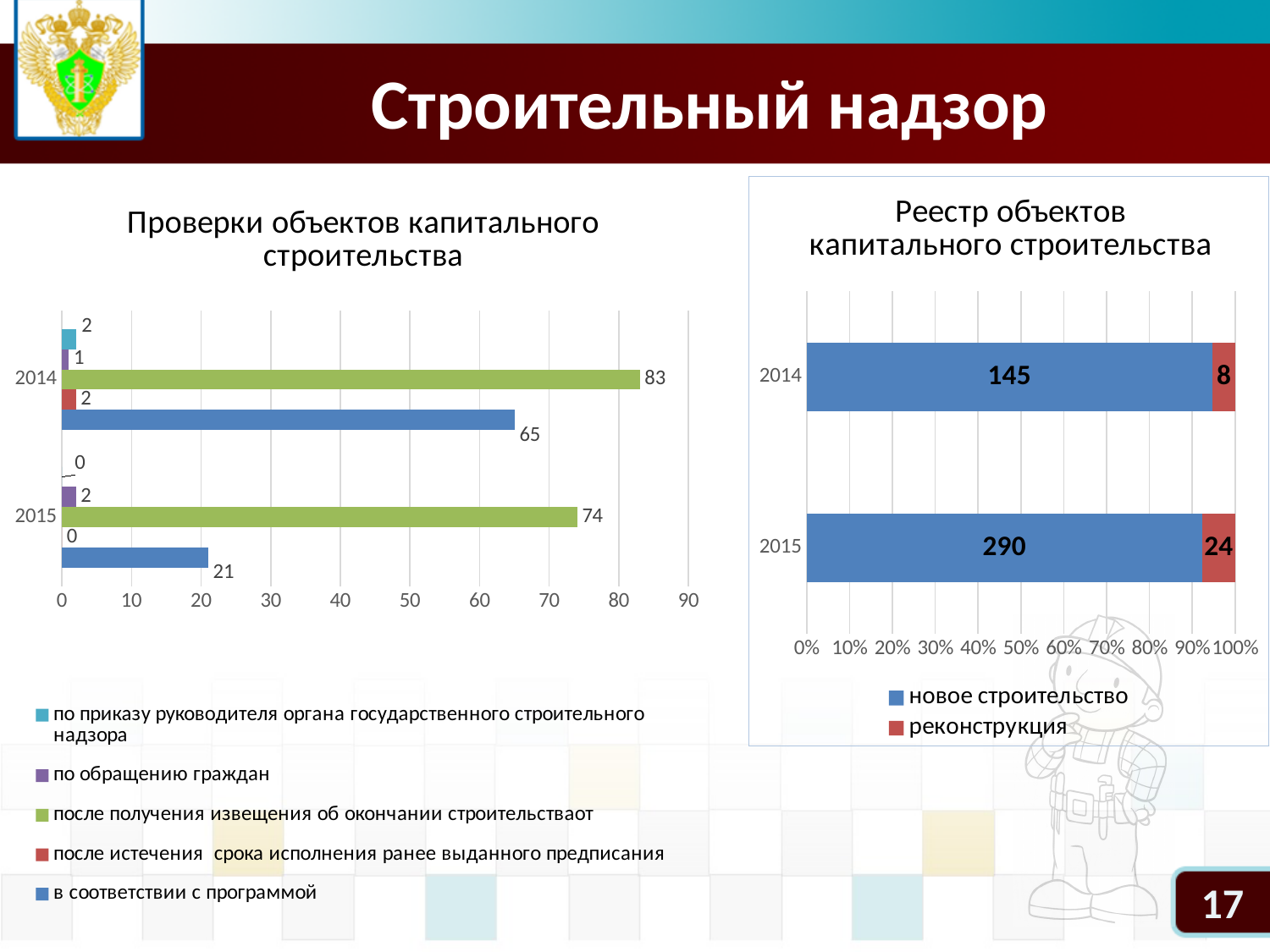
In the chart 'Реестр объектов капитального строительства', what is the value for 'реконструкция' in 2014? 8 In the chart 'Проверки объектов капитального строительства', what is the difference between the 'в соответствии с программой' values for 2014 and 2015? 44 In the chart 'Проверки объектов капитального строительства', is the 'после получения извещения об окончании строительства' value for 2015 greater or less than 70? greater In the chart 'Проверки объектов капитального строительства', what is the value for 'после получения извещения об окончании строительства' in 2014? 83 In the chart 'Проверки объектов капитального строительства', what is the value for 'по обращению граждан' in 2015? 2 In the chart 'Реестр объектов капитального строительства', what is the value for 'новое строительство' in 2015? 290 What kind of chart is 'Реестр объектов капитального строительства'? Stacked bar chart In the chart 'Реестр объектов капитального строительства', which is larger: 'реконструкция' in 2014 or 'реконструкция' in 2015? 2015 In the chart 'Проверки объектов капитального строительства', how many series does the legend list? 5 In the chart 'Проверки объектов капитального строительства', which series has the highest value in 2014? после получения извещения об окончании строительства In the chart 'Реестр объектов капитального строительства', what is the total of the 2015 bar? 314 In the chart 'Проверки объектов капитального строительства', what is the value for 'в соответствии с программой' in 2015? 21